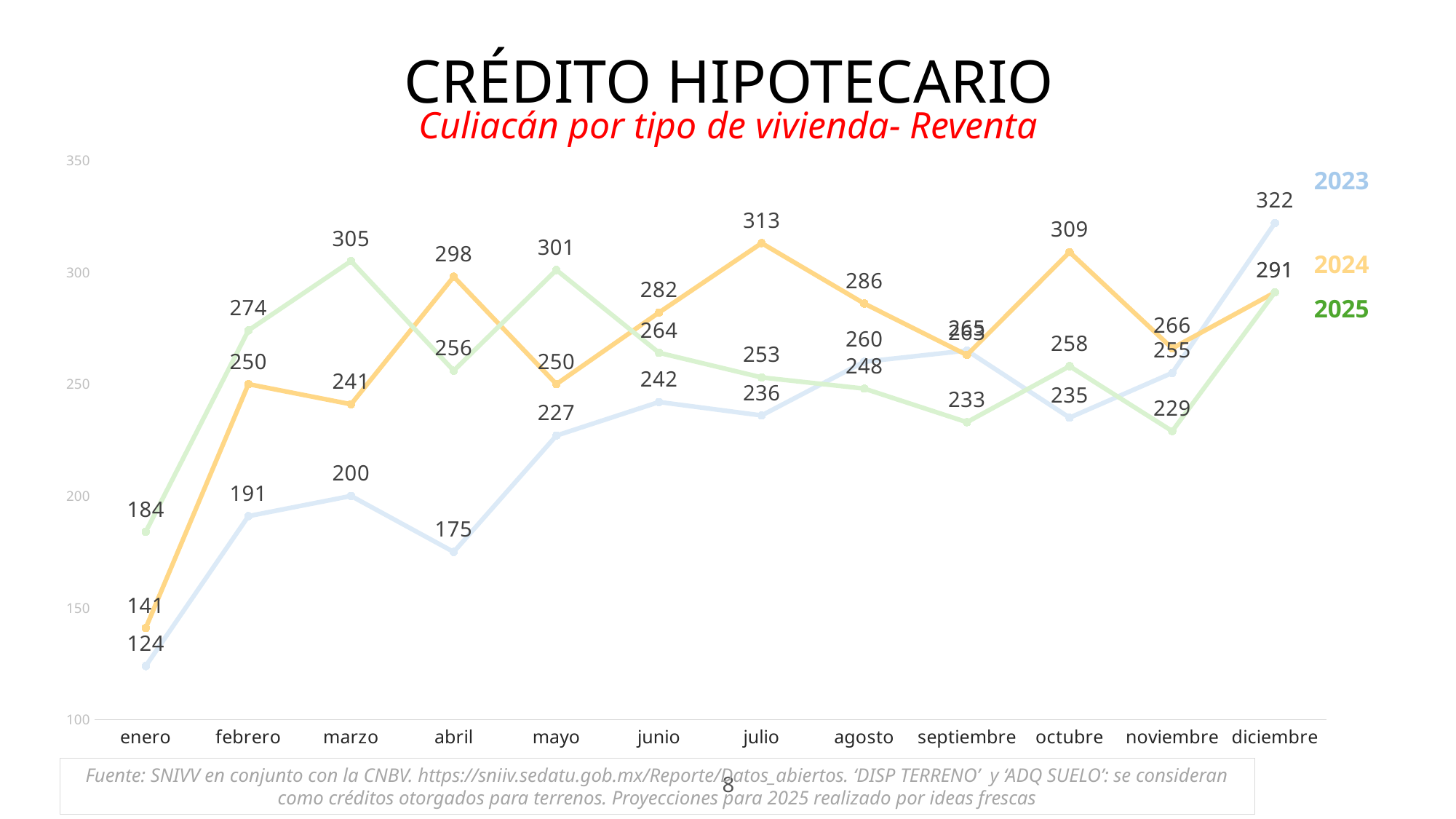
What is the value for 2025 in marzo? 305 What is the value for 2023 in enero? 124 In which month does the 2024 series have its lowest value? enero What is the value for 2024 in julio? 313 What kind of chart is shown on the slide? line chart Is the 2023 value for abril greater or less than 200? less How many series does the legend list? 3 How many months are shown on the x axis? 12 In marzo, which series has the larger value, 2024 or 2025? 2025 In which month does the 2023 series reach its highest value? diciembre What is the difference between the 2023 values for diciembre and enero? 198 What is the value for 2025 in noviembre? 229